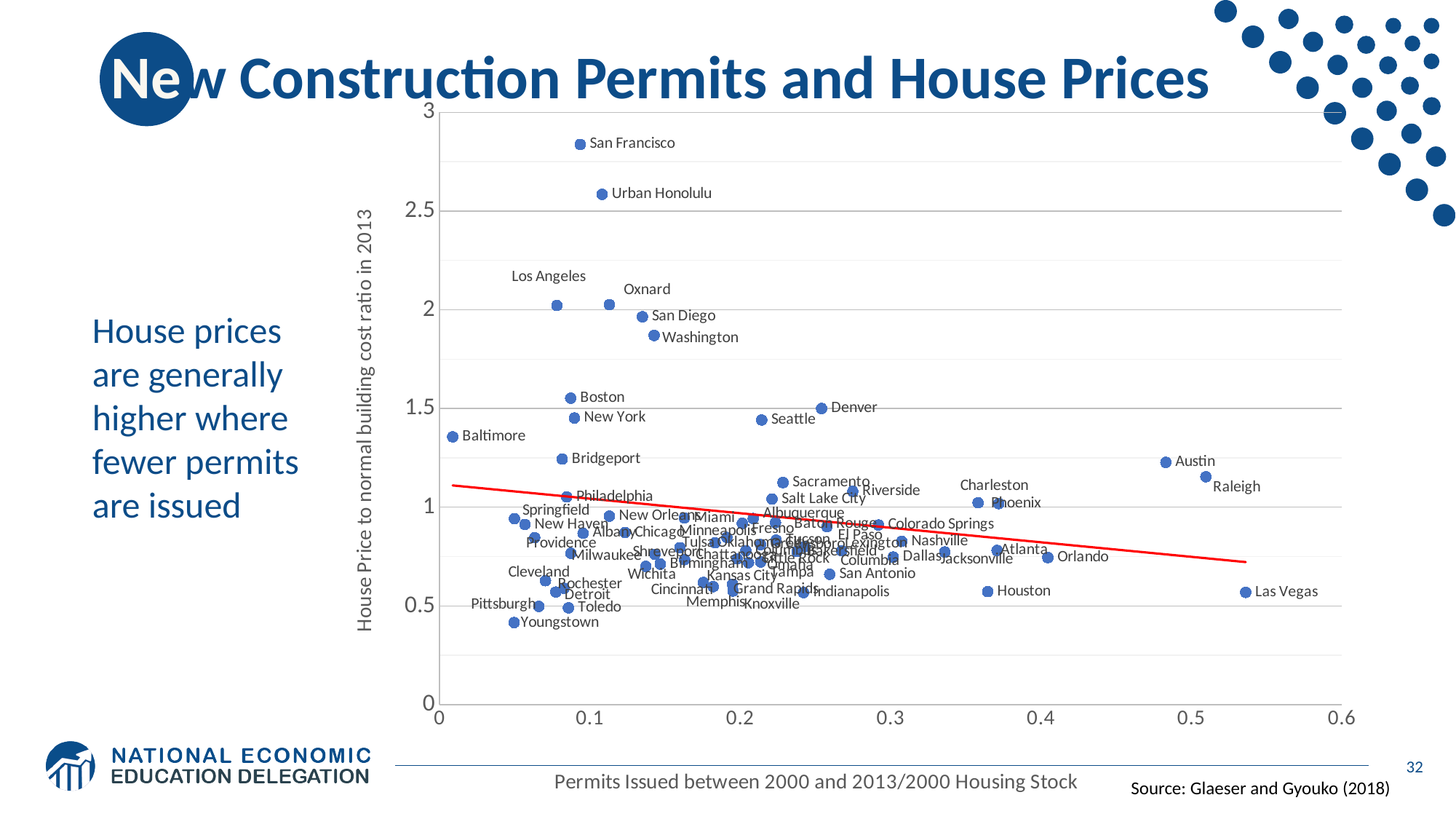
What is the label of the horizontal axis of the chart? Permits Issued between 2000 and 2013/2000 Housing Stock Which city has the lowest house price to normal building cost ratio on the chart? Youngstown Is the permits issued value for Las Vegas greater or less than 0.5? greater Which city is plotted furthest to the right, with the highest permits issued ratio? Las Vegas Which city has a higher house price to building cost ratio, San Francisco or Urban Honolulu? San Francisco Is the house price to building cost ratio for San Francisco greater or less than 2.5? greater What kind of chart is shown on the slide? scatter chart Is the house price to building cost ratio for Houston greater or less than 1? less Which city has the highest house price to normal building cost ratio on the chart? San Francisco According to the trend line, do house price ratios rise or fall as the permits issued ratio increases? fall